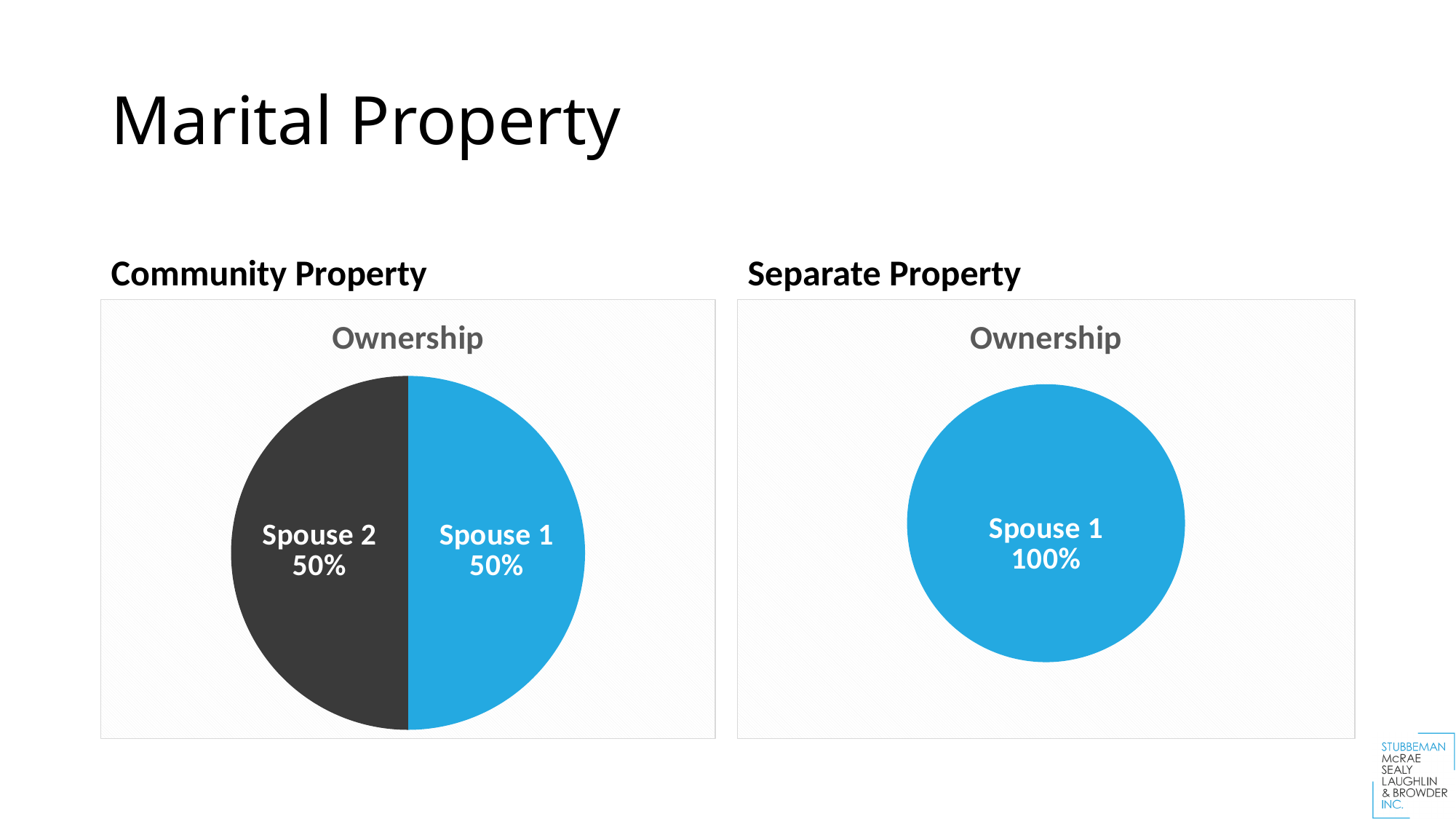
In the Separate Property chart, what share of ownership does Spouse 1 have? 100% What is the title shown inside the Community Property chart? Ownership What kind of chart is the Community Property chart? Pie chart How many slices does the Community Property pie chart have? 2 In the Community Property chart, what share of ownership does Spouse 1 have? 50% Which spouse is shown in the Separate Property chart? Spouse 1 In the Community Property chart, what is the difference between Spouse 1's share and Spouse 2's share? 0% What kind of chart is the Separate Property chart? Pie chart How many slices does the Separate Property pie chart have? 1 In the Community Property chart, what share of ownership does Spouse 2 have? 50% In the Community Property chart, what colour is the Spouse 2 slice? Dark grey